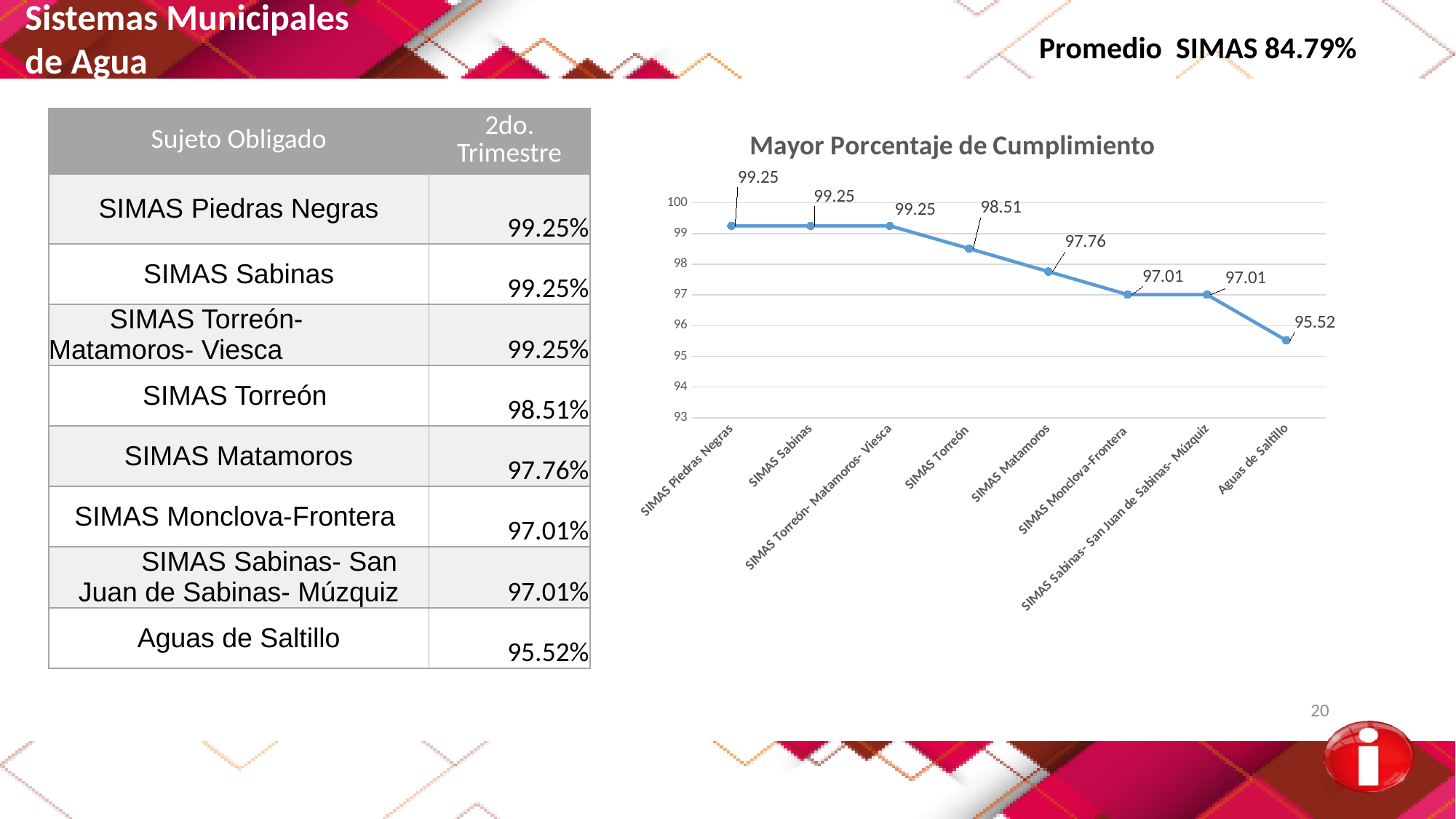
Is the value for Aguas de Saltillo greater or less than 96? less What is the value for SIMAS Matamoros in the chart? 97.76 Which category has the lowest value in the chart? Aguas de Saltillo Which is larger, the value for SIMAS Matamoros or the value for SIMAS Monclova-Frontera? SIMAS Matamoros What kind of chart is shown on the slide? line chart What is the value for Aguas de Saltillo in the chart? 95.52 What is the value for SIMAS Torreón in the chart? 98.51 Do the values rise or fall moving from left to right along the x axis? fall What is the value for SIMAS Monclova-Frontera in the chart? 97.01 What is the difference between the values for SIMAS Torreón and Aguas de Saltillo? 2.99 How many categories are plotted on the x axis of the chart? 8 What is the title of the chart? Mayor Porcentaje de Cumplimiento